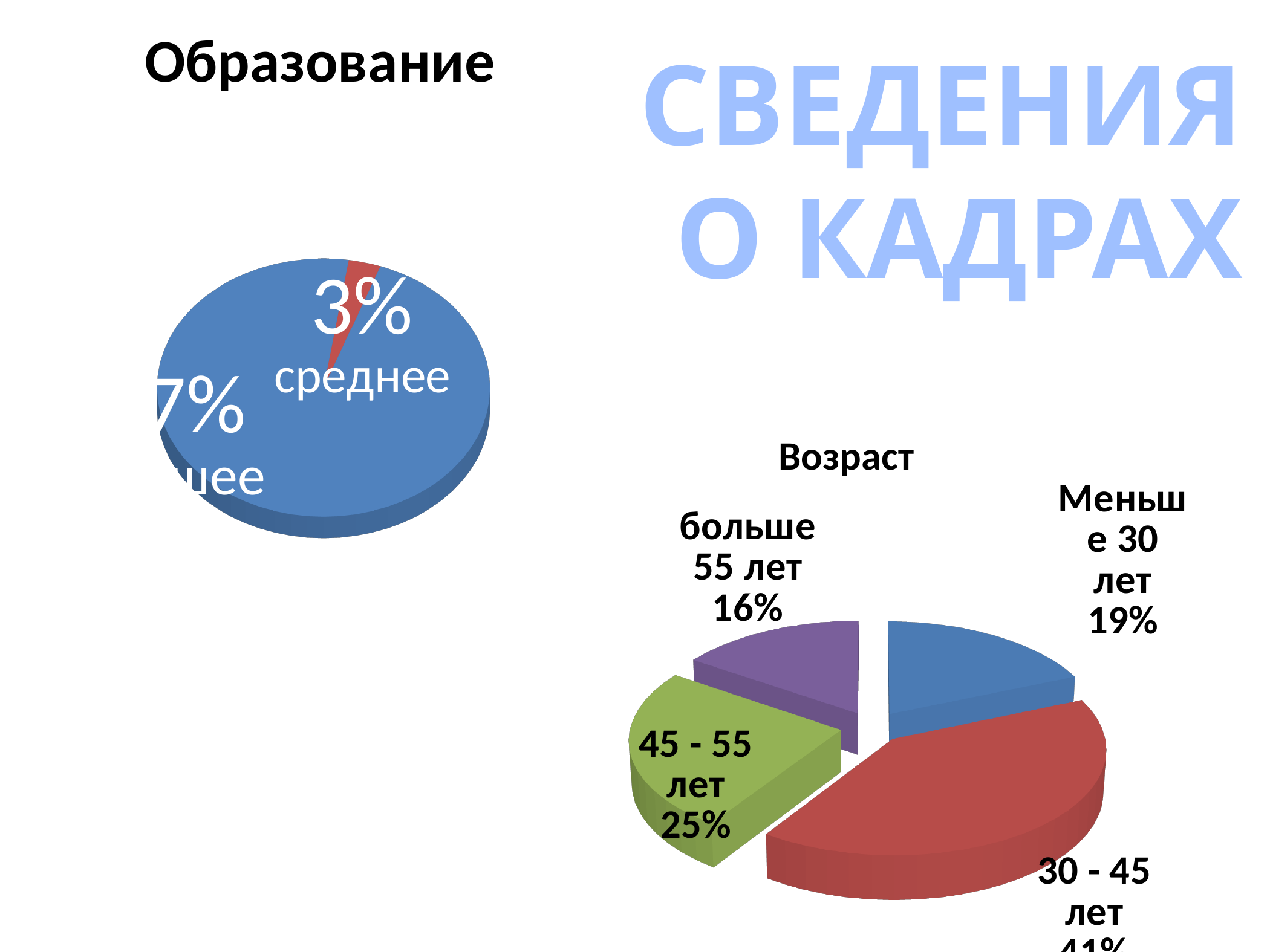
In the "Возраст" chart, what is the difference in percentage points between "45 - 55 лет" and "больше 55 лет"? 9 percentage points In the "Возраст" chart, what is the difference in percentage points between "45 - 55 лет" and "Меньше 30 лет"? 6 percentage points In the "Возраст" chart, what percentage is shown for "45 - 55 лет"? 25% In the "Возраст" chart, which age group has the smallest slice? больше 55 лет How many slices does the "Образование" chart have? 2 In the "Образование" chart, what percentage is shown for "среднее"? 3% In the "Возраст" chart, which age group has the largest slice? 30 - 45 лет In the "Возраст" chart, what percentage is shown for "Меньше 30 лет"? 19% How many slices does the "Возраст" chart have? 4 What kind of chart is the "Образование" chart? Pie chart In the "Возраст" chart, which is larger: "Меньше 30 лет" or "больше 55 лет"? Меньше 30 лет In the "Возраст" chart, what percentage is shown for "больше 55 лет"? 16%